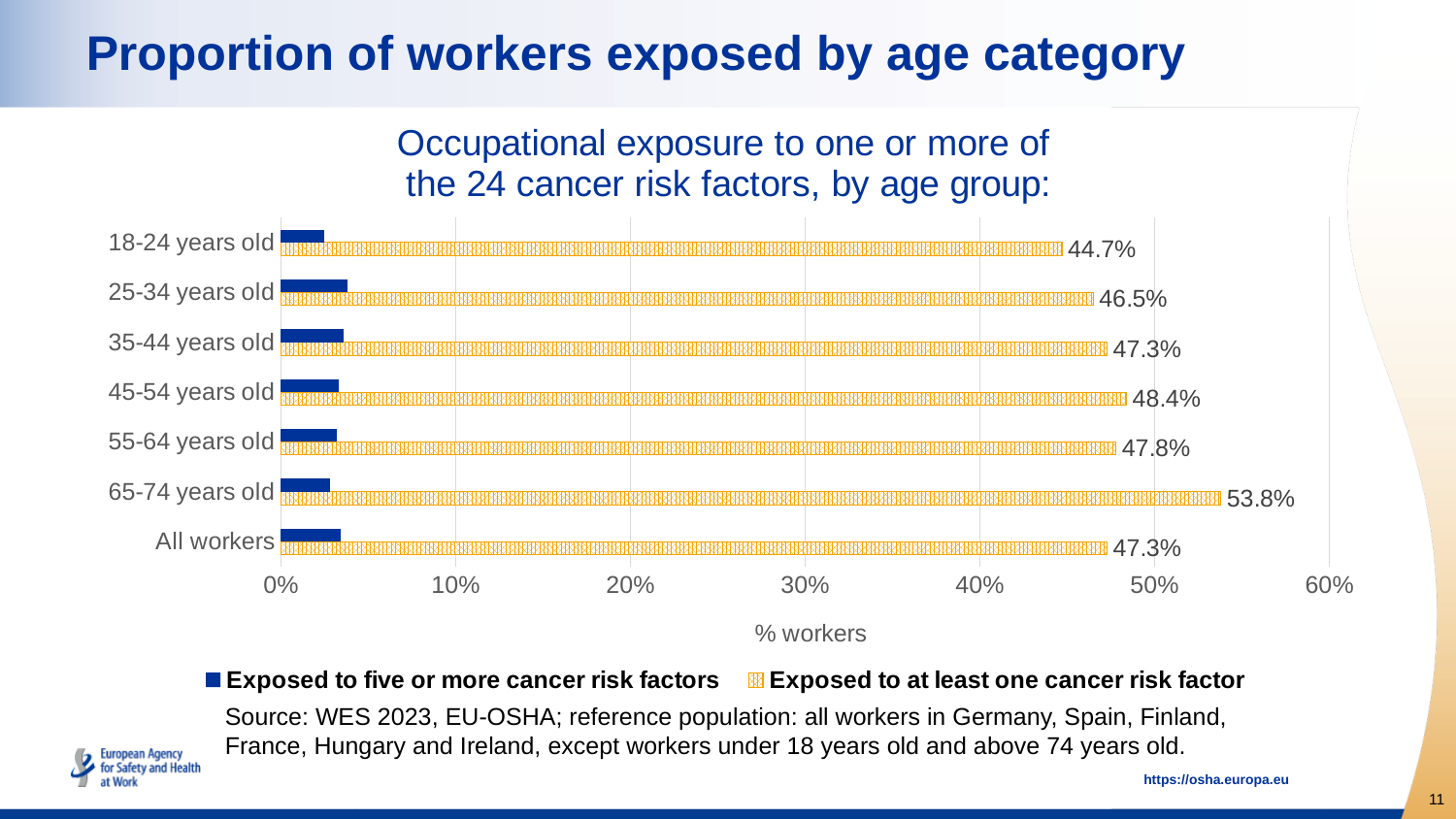
Which age group has the lowest proportion of workers exposed to at least one cancer risk factor? 18-24 years old What kind of chart is shown on the slide? Bar chart What percentage of all workers are exposed to at least one cancer risk factor? 47.3% What is the difference in percentage points between the 65-74 years old and 18-24 years old groups for exposure to at least one cancer risk factor? 9.1 percentage points Which age group has the highest proportion of workers exposed to at least one cancer risk factor? 65-74 years old Is the value for 'Exposed to five or more cancer risk factors' for the 25-34 years old group greater or less than 10%? less How many series does the legend list? 2 For exposure to at least one cancer risk factor, which is larger: the 45-54 years old group or the 55-64 years old group? 45-54 years old What percentage of workers aged 18-24 are exposed to at least one cancer risk factor? 44.7% How many categories are shown on the y axis of the chart? 7 What is the value for 'Exposed to at least one cancer risk factor' for the 65-74 years old group? 53.8% What is the title of the x axis of the chart? % workers